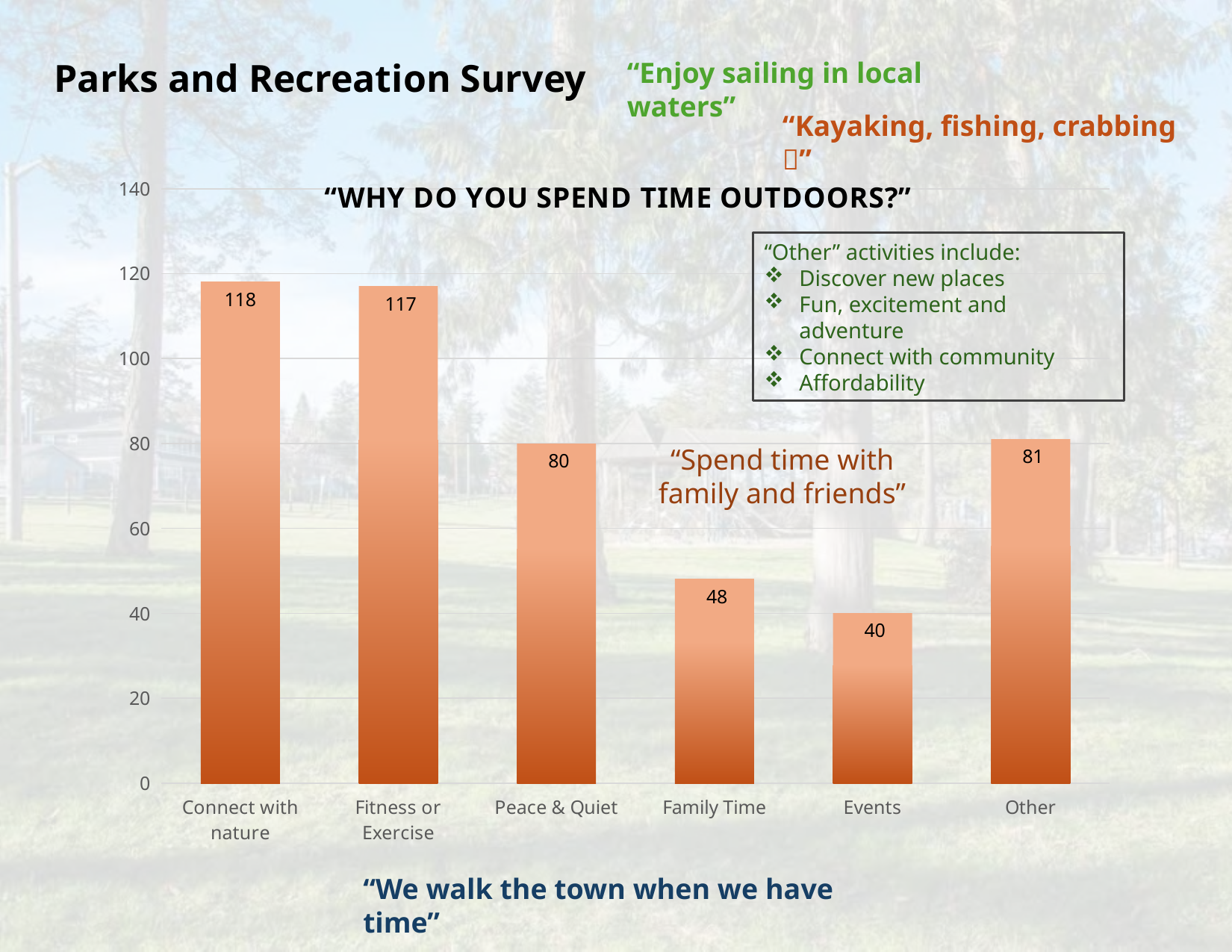
Which is larger, Family Time or Events? Family Time Which category has the lowest value? Events What is the title of the chart? "WHY DO YOU SPEND TIME OUTDOORS?" What is the value for Peace & Quiet? 80 What is the difference between Peace & Quiet and Events? 40 What is the difference between Connect with nature and Family Time? 70 How many categories are shown on the x axis? 6 What is the value for Events? 40 What is the value for Other? 81 What kind of chart is shown on the slide? Bar chart What is the value for Connect with nature? 118 Which is larger, Fitness or Exercise or Peace & Quiet? Fitness or Exercise